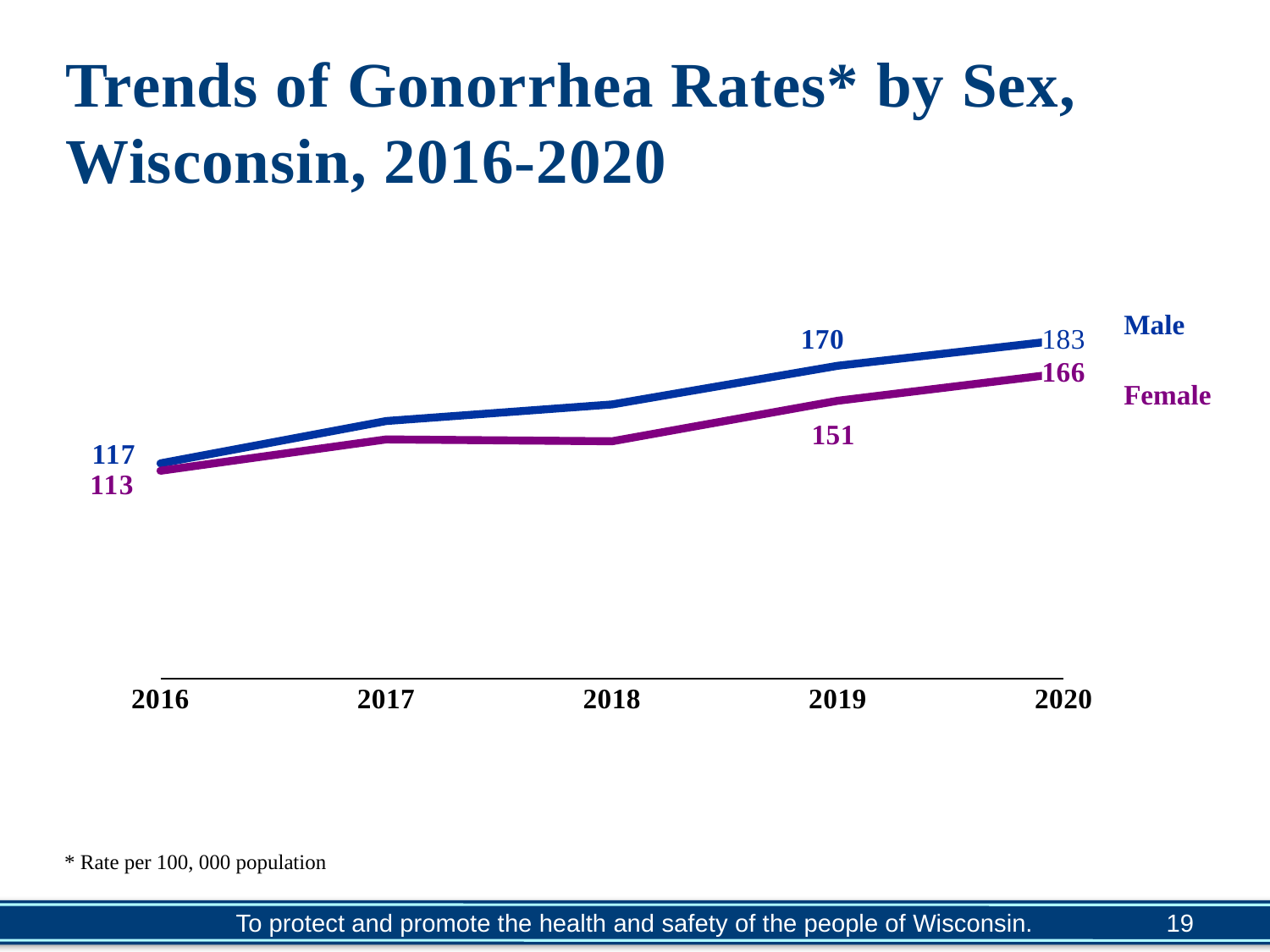
What was the male gonorrhea rate in Wisconsin in 2020? 183 In which year was the male gonorrhea rate highest? 2020 In 2019, which sex had the higher gonorrhea rate? Male How many years are shown on the x axis of the chart? 5 In which year was the female gonorrhea rate lowest? 2016 By how much did the male gonorrhea rate increase from 2016 to 2020? 66 What was the male gonorrhea rate in 2016? 117 What was the female gonorrhea rate in 2019? 151 What type of chart is shown on the slide? Line chart What was the female gonorrhea rate in Wisconsin in 2016? 113 How many series does the chart show? 2 What is the difference between the male and female gonorrhea rates in 2020? 17